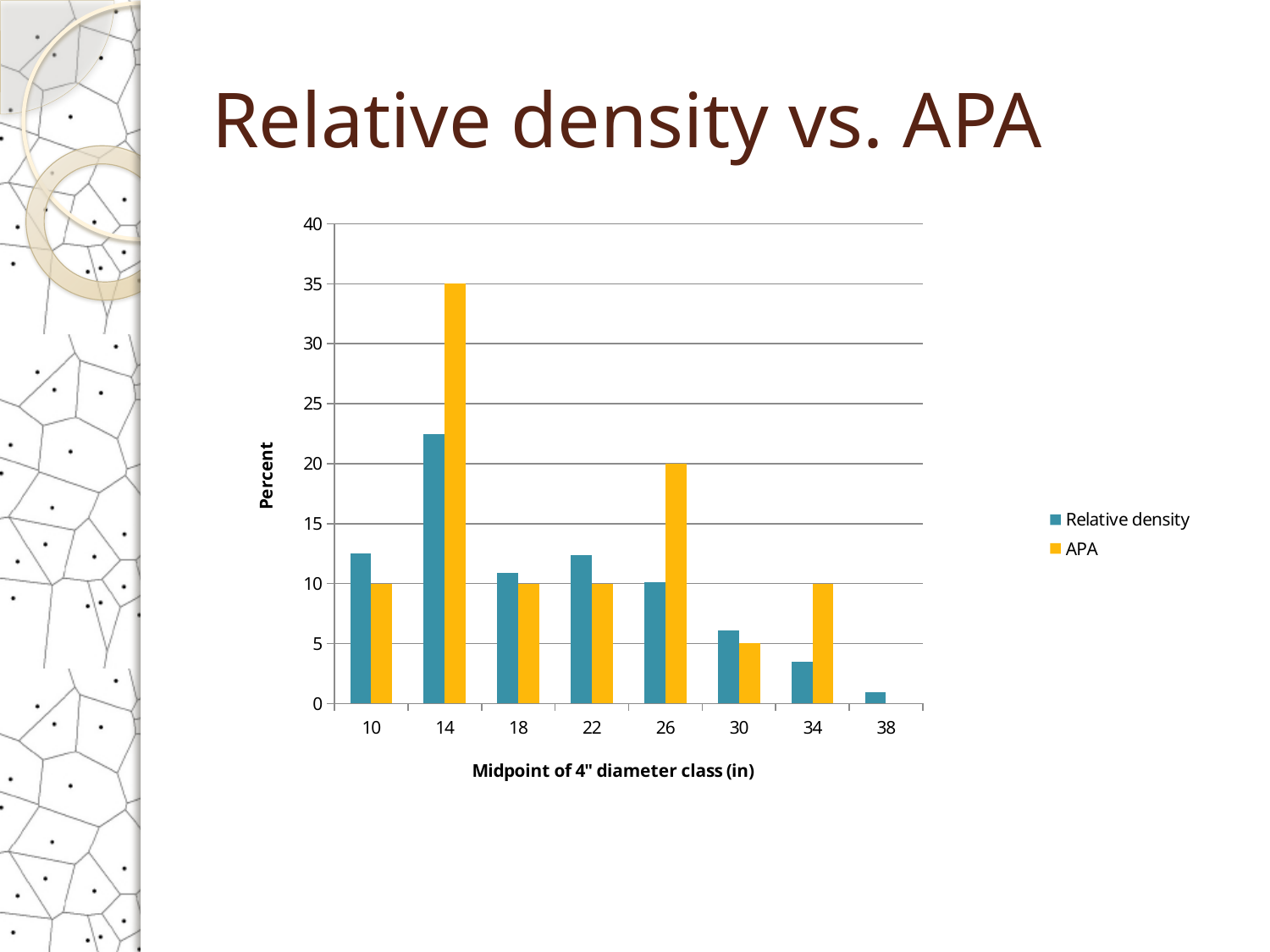
Is the Relative density value for the 14-inch class greater or less than 20? greater What is the APA value for the 26-inch diameter class? 20 What is the difference between the APA values for the 14-inch and 26-inch classes? 15 What is the APA value for the 14-inch diameter class? 35 What is the title of the x axis? Midpoint of 4" diameter class (in) What kind of chart is shown on the slide? bar chart Which diameter class has the highest APA value? 14 How many diameter class midpoints are shown on the x axis? 8 How many series does the legend list? 2 Is the Relative density value for the 38-inch class greater or less than 5? less For the 34-inch class, which is larger: Relative density or APA? APA Among the classes with an APA bar, which has the lowest APA value? 30